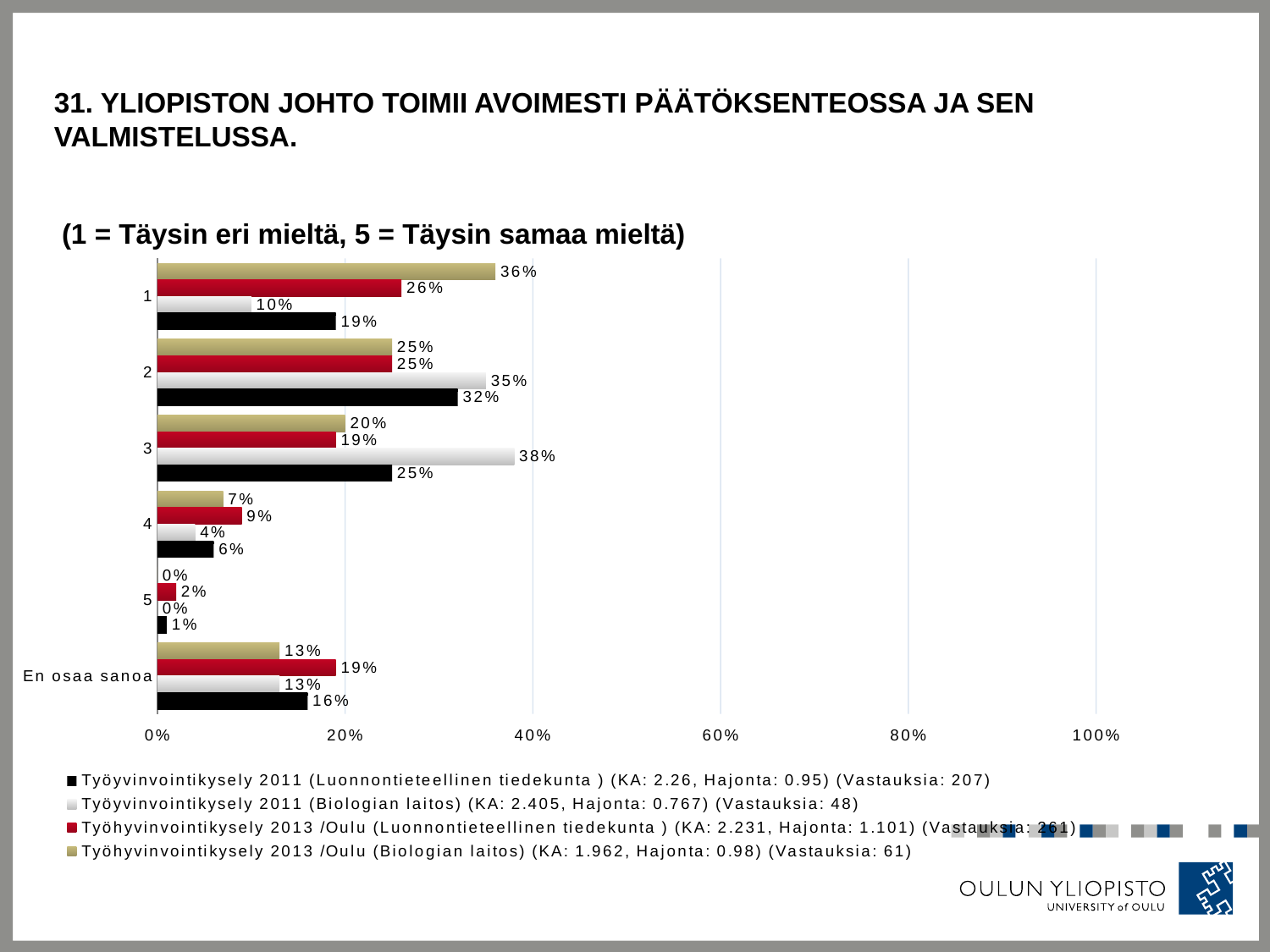
How many series does the legend list? 4 What is the value for category 1 in the Työhyvinvointikysely 2013 /Oulu (Biologian laitos) series? 36% What is the value for category 3 in the Työyvinvointikysely 2011 (Biologian laitos) series? 38% What is the value for category 2 in the Työyvinvointikysely 2011 (Luonnontieteellinen tiedekunta) series? 32% Is the value for category 2 in the Työyvinvointikysely 2011 (Biologian laitos) series greater or less than 20%? greater What kind of chart is shown on the slide? bar chart What is the value for En osaa sanoa in the Työhyvinvointikysely 2013 /Oulu (Luonnontieteellinen tiedekunta) series? 19% How many categories are shown on the vertical axis of the chart? 6 What is the difference between the Työyvinvointikysely 2011 (Biologian laitos) value and the Työhyvinvointikysely 2013 /Oulu (Biologian laitos) value for category 1? 26% Which category has the highest value in the Työyvinvointikysely 2011 (Biologian laitos) series? 3 Which category has the lowest value in the Työhyvinvointikysely 2013 /Oulu (Luonnontieteellinen tiedekunta) series? 5 For category 4, which series has the larger value: Työhyvinvointikysely 2013 /Oulu (Luonnontieteellinen tiedekunta) or Työyvinvointikysely 2011 (Biologian laitos)? Työhyvinvointikysely 2013 /Oulu (Luonnontieteellinen tiedekunta)